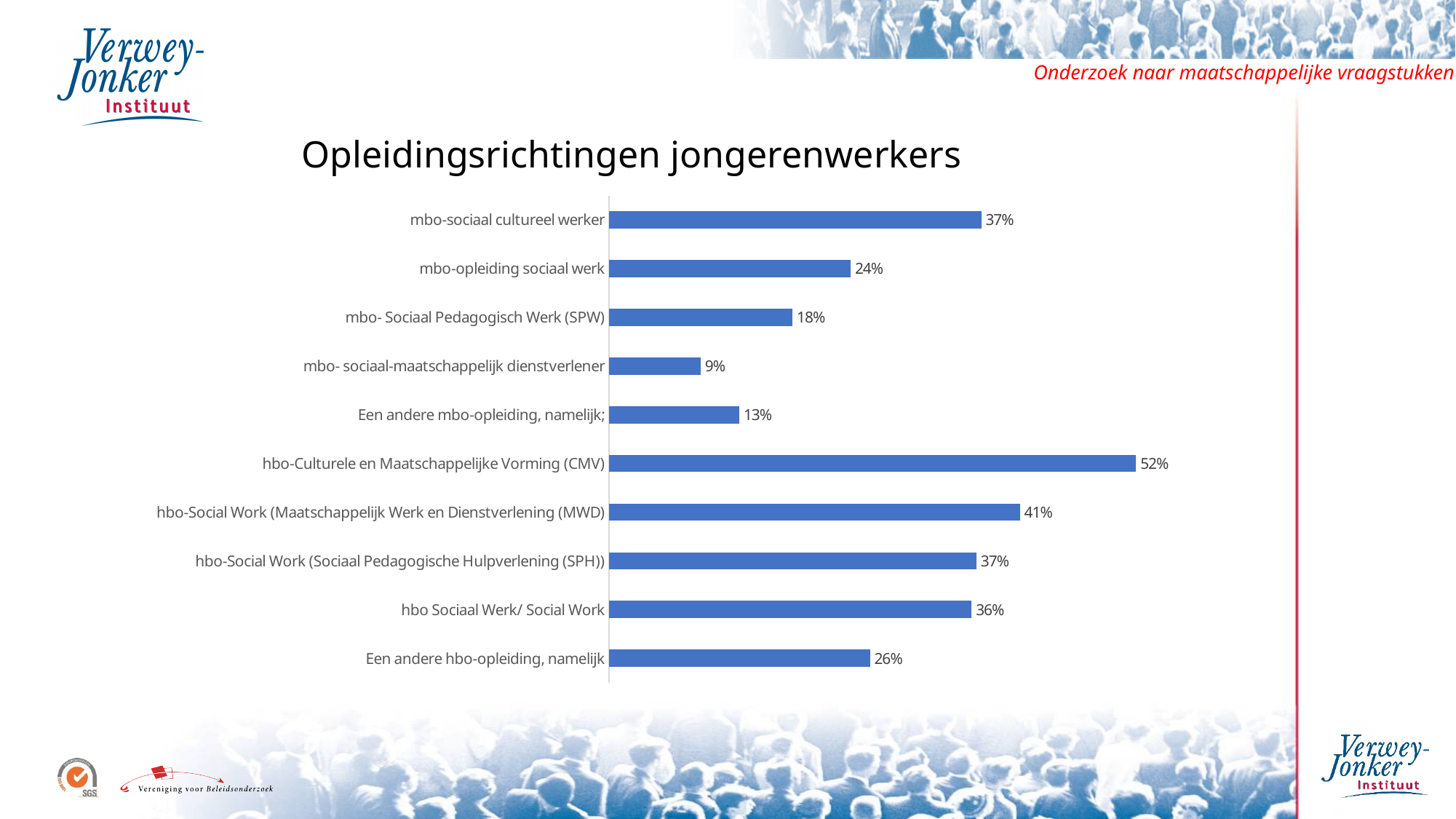
What is the value for mbo-opleiding sociaal werk? 24% What is the value for Een andere hbo-opleiding, namelijk? 26% What is the difference between the values for mbo- Sociaal Pedagogisch Werk (SPW) and mbo- sociaal-maatschappelijk dienstverlener? 9% What is the value for hbo-Culturele en Maatschappelijke Vorming (CMV)? 52% What is the title of the chart? Opleidingsrichtingen jongerenwerkers Which is larger: the value for Een andere mbo-opleiding, namelijk; or the value for mbo-opleiding sociaal werk? mbo-opleiding sociaal werk Which category has the highest value? hbo-Culturele en Maatschappelijke Vorming (CMV) Which category has the lowest value? mbo- sociaal-maatschappelijk dienstverlener How many categories are shown in the chart? 10 What kind of chart is shown on the slide? Bar chart Which is larger: the value for hbo-Social Work (Maatschappelijk Werk en Dienstverlening (MWD) or the value for hbo Sociaal Werk/ Social Work? hbo-Social Work (Maatschappelijk Werk en Dienstverlening (MWD) What is the difference between the values for hbo-Culturele en Maatschappelijke Vorming (CMV) and mbo-sociaal cultureel werker? 15%